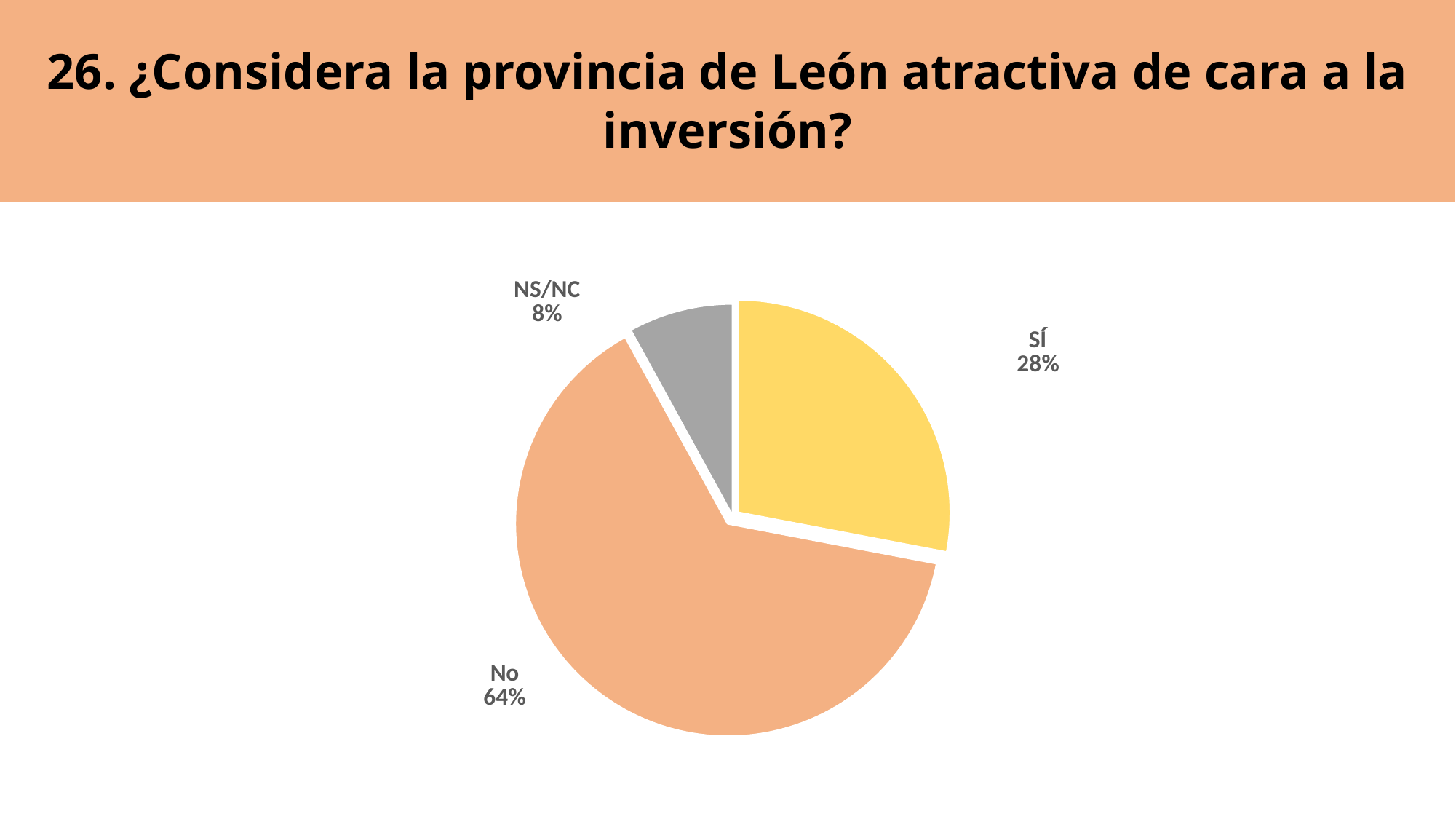
What share of the pie does the "No" slice represent? 64% What is the difference in percentage points between the "No" and "SÍ" slices? 36 What colour is the "SÍ" slice? yellow How many slices does the pie chart have? 3 What percentage of respondents answered "No"? 64% What is the difference in percentage points between the "SÍ" and "NS/NC" slices? 20 Which is larger, the share for "SÍ" or the share for "NS/NC"? SÍ What percentage of respondents answered "NS/NC"? 8% Which response has the smallest share of the pie? NS/NC What kind of chart is shown on the slide? pie chart Which response has the largest share of the pie? No What percentage of respondents answered "SÍ"? 28%